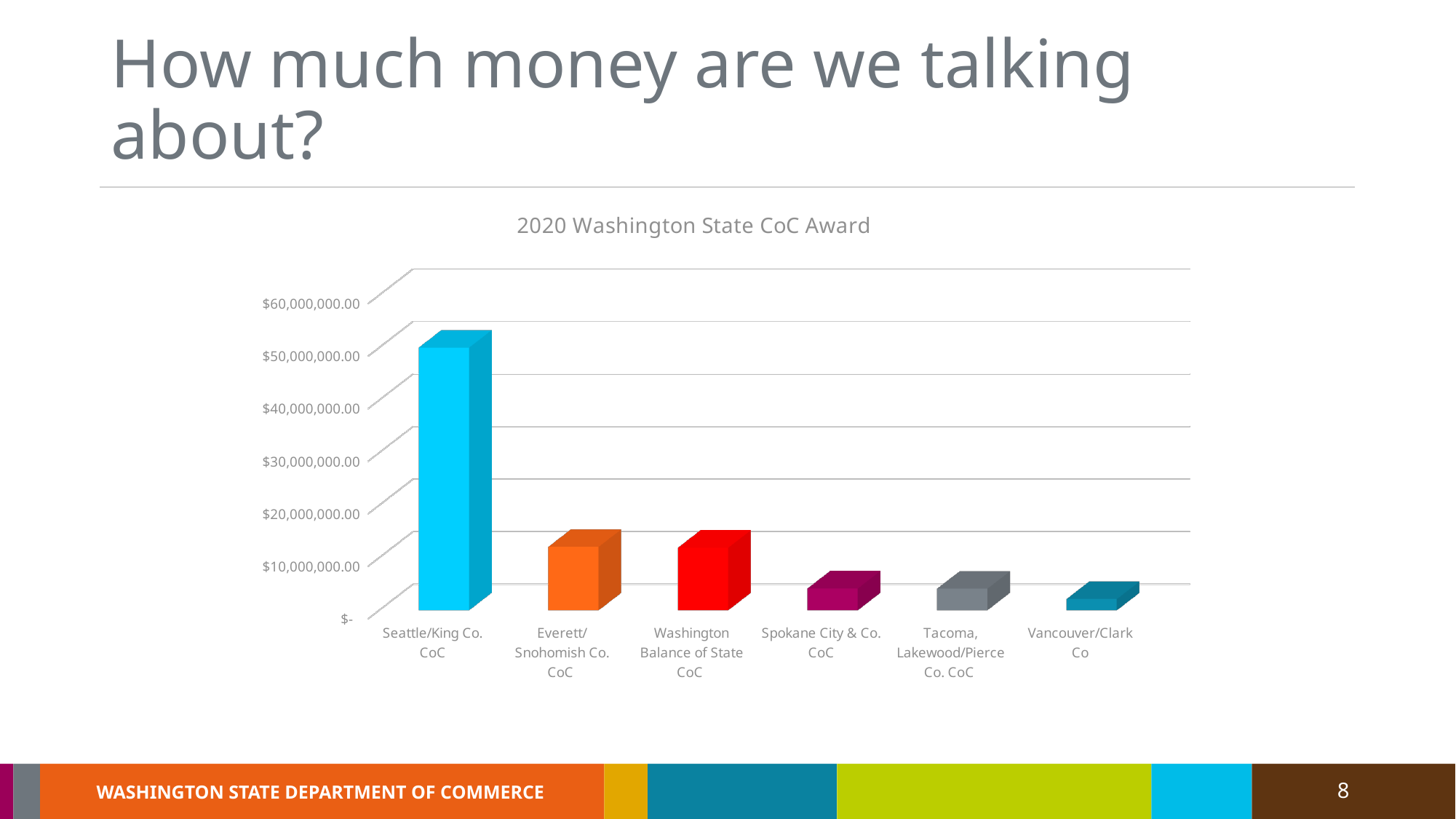
Is the value for Seattle/King Co. CoC greater or less than $40,000,000.00? greater Is the value for Tacoma, Lakewood/Pierce Co. CoC greater or less than $10,000,000.00? less Do the award values generally rise or fall moving from left to right across the chart? fall Is the value for Everett/Snohomish Co. CoC greater or less than $10,000,000.00? greater Which received a larger award, Seattle/King Co. CoC or Everett/Snohomish Co. CoC? Seattle/King Co. CoC Which CoC received the lowest 2020 award? Vancouver/Clark Co What is the title of the chart? 2020 Washington State CoC Award Which received a larger award, Everett/Snohomish Co. CoC or Spokane City & Co. CoC? Everett/Snohomish Co. CoC Which CoC received the highest 2020 award? Seattle/King Co. CoC How many CoC categories are plotted in the chart? 6 What kind of chart is shown on the slide? bar chart